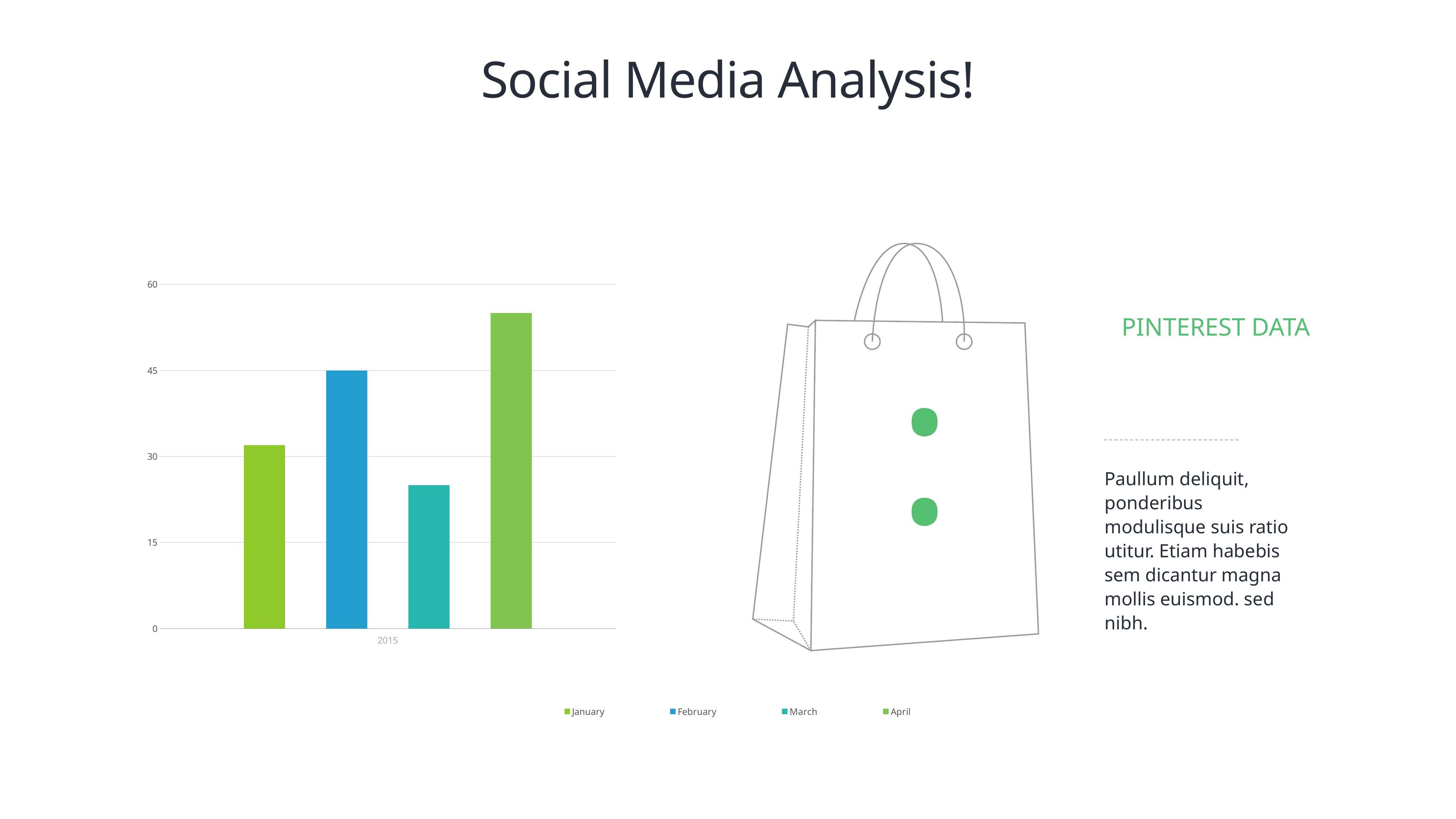
Which is larger, the February bar or the April bar? April Is the value for April greater or less than 45? greater What kind of chart is shown on the slide? bar chart Is the value for January greater or less than 30? greater Which month has the lowest bar in the chart? March Which month has the highest bar in the chart? April Is the value for March greater or less than 30? less How many series does the chart's legend list? 4 What is the value of the February bar for 2015? 45 Which is larger, the January bar or the March bar? January How many categories are shown on the x axis of the chart? 1 What category label appears on the x axis of the chart? 2015